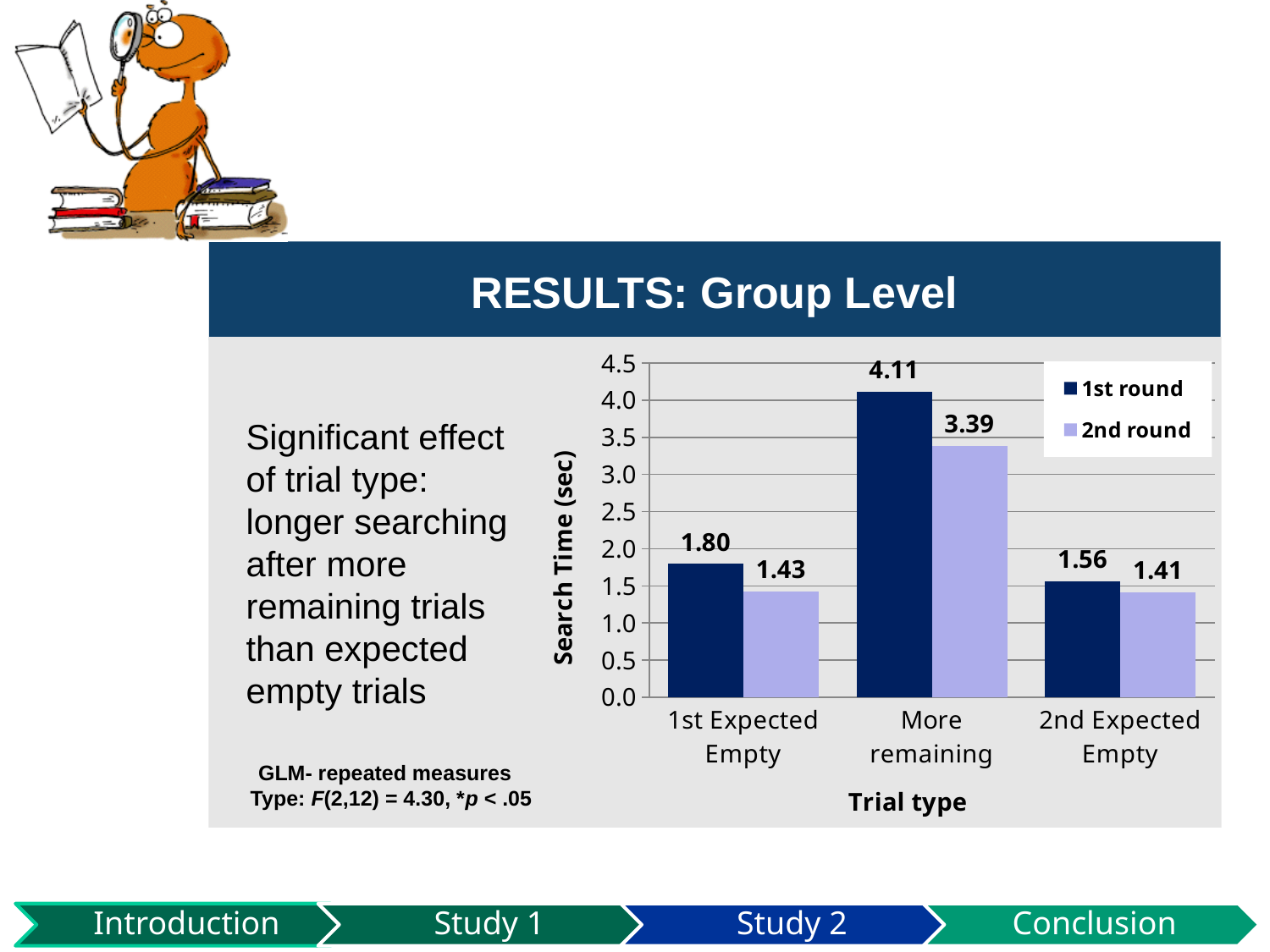
What is the 2nd round search time for the 1st Expected Empty trial type? 1.43 Which trial type has the highest 1st round search time? More remaining Which is larger: the 1st round search time for 1st Expected Empty or the 2nd round search time for More remaining? 2nd round search time for More remaining What is the label of the y axis? Search Time (sec) What is the difference between the 1st round search times for 1st Expected Empty and 2nd Expected Empty? 0.24 What is the 2nd round search time for the 2nd Expected Empty trial type? 1.41 What is the difference between the 1st round and 2nd round search times for More remaining? 0.72 What is the 1st round search time for the More remaining trial type? 4.11 What kind of chart is shown on the slide? Bar chart How many series does the legend list? 2 How many trial types are shown on the x axis? 3 Which trial type has the lowest 2nd round search time? 2nd Expected Empty